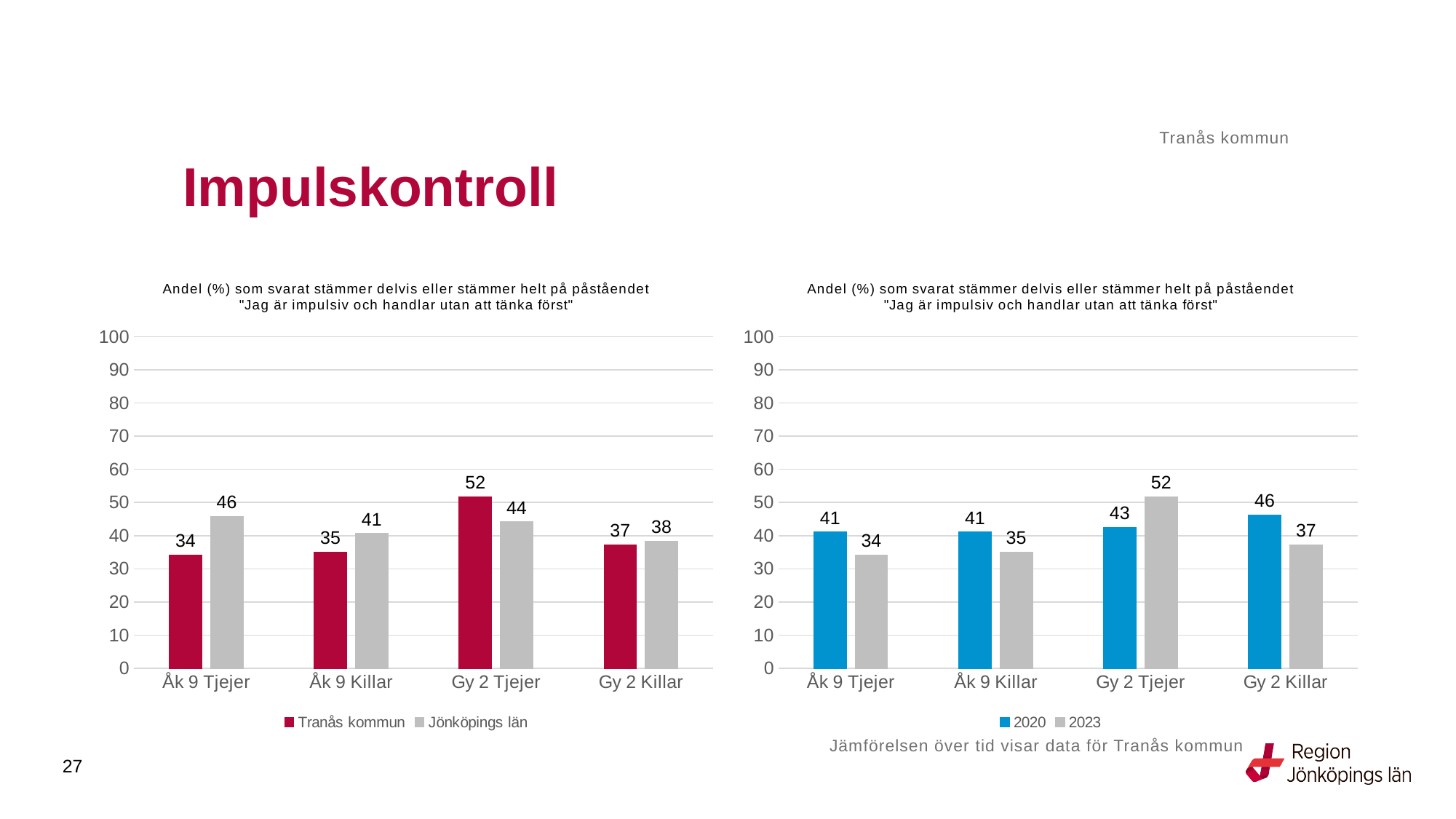
In the right chart, what is the difference between the 2020 and 2023 values for Gy 2 Killar? 9 In the right chart, which category has the highest 2023 value? Gy 2 Tjejer In the left chart, what is the value for Tranås kommun for Gy 2 Tjejer? 52 How many categories are shown on the x axis of the left chart? 4 In the right chart, what is the 2020 value for Gy 2 Killar? 46 In the left chart, what is the value for Jönköpings län for Åk 9 Tjejer? 46 In the right chart, what is the 2023 value for Gy 2 Tjejer? 52 In the left chart, which category has the lowest value for Tranås kommun? Åk 9 Tjejer How many series does the legend of the right chart list? 2 In the left chart, what is the difference between Jönköpings län and Tranås kommun for Åk 9 Tjejer? 12 In the left chart, which is larger for Gy 2 Tjejer: Tranås kommun or Jönköpings län? Tranås kommun What type of chart is the right chart? Bar chart